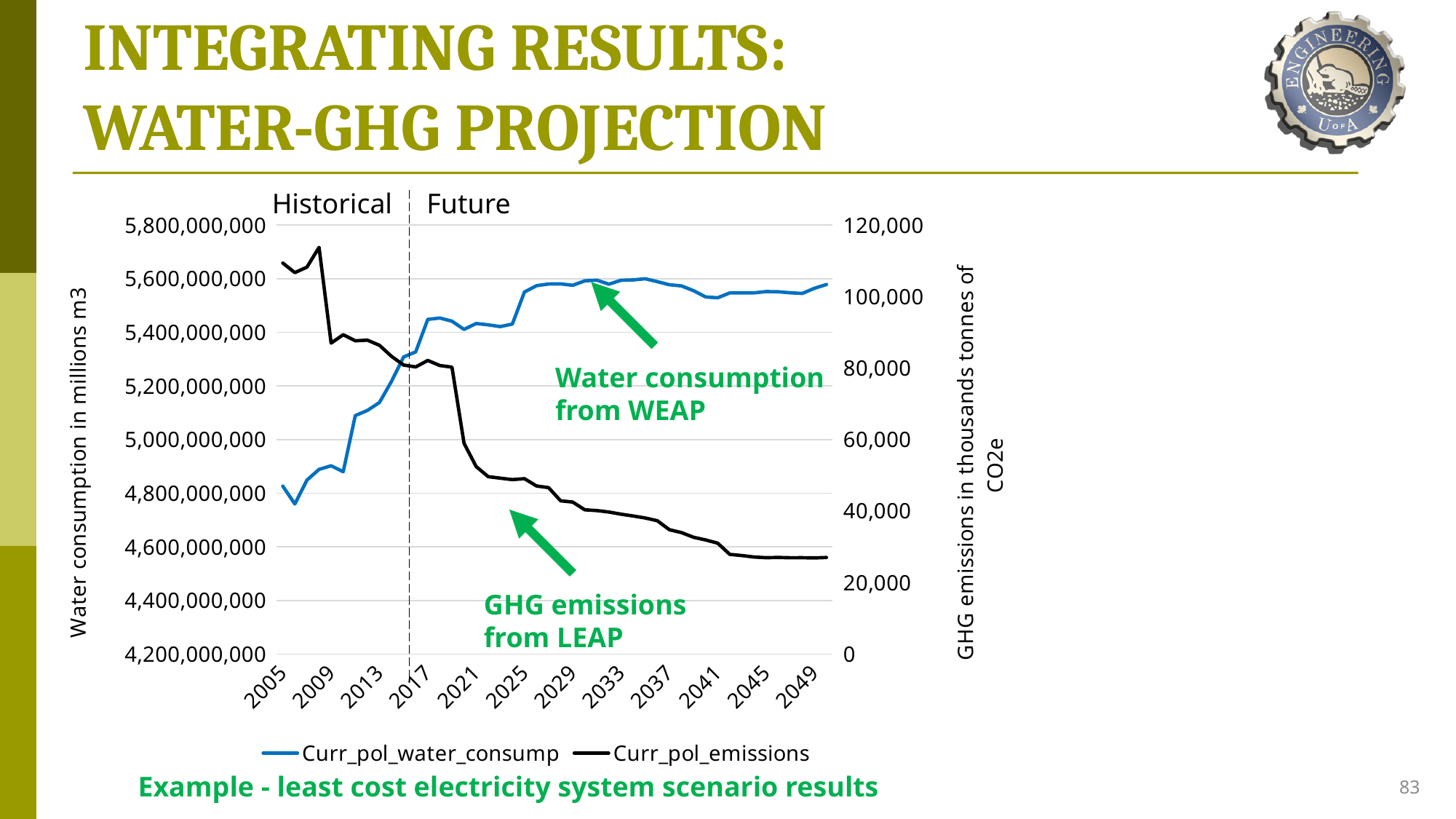
How many series does the legend list? 2 What kind of chart is shown on the slide? line chart Is the Curr_pol_emissions value in 2049 greater or less than 40,000? less How many year labels are shown on the x axis? 12 What are the two series named in the legend? Curr_pol_water_consump and Curr_pol_emissions Is the Curr_pol_water_consump value in 2049 greater or less than 5,400,000,000? greater Which year has the larger Curr_pol_emissions value, 2005 or 2049? 2005 Does the Curr_pol_emissions line rise or fall from 2005 to 2049? fall Is the Curr_pol_water_consump value in 2005 greater or less than 5,000,000,000? less Does the Curr_pol_water_consump line rise or fall overall from 2005 to 2049? rise What is the title of the right-hand vertical axis? GHG emissions in thousands tonnes of CO2e